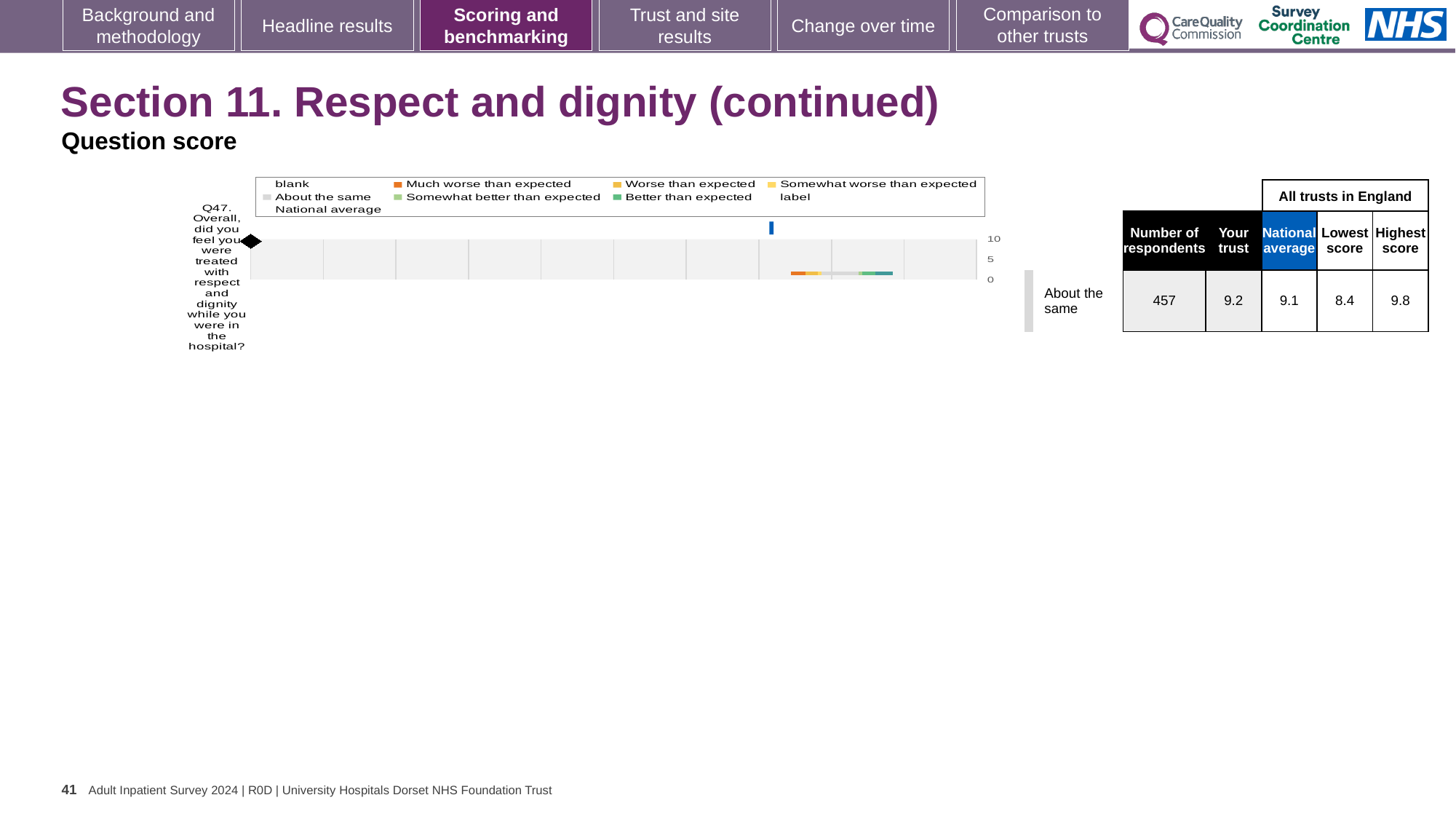
What is the difference between the highest and lowest scores among all trusts in England for Q47? 1.4 What is the national average score for Q47? 9.1 Which is larger for Q47, the trust's score or the national average? Your trust What is the difference between the trust's score and the national average for Q47? 0.1 How many respondents answered Q47? 457 What is the highest score among all trusts in England for Q47? 9.8 How many questions are plotted on the chart? 1 Which question is plotted on the chart? Q47. Overall, did you feel you were treated with respect and dignity while you were in the hospital? What is the trust's score for Q47 shown in the table next to the chart? 9.2 What is the maximum value shown on the chart's score axis? 10 What is the lowest score among all trusts in England for Q47? 8.4 Which benchmarking category is the trust's Q47 score placed in? About the same